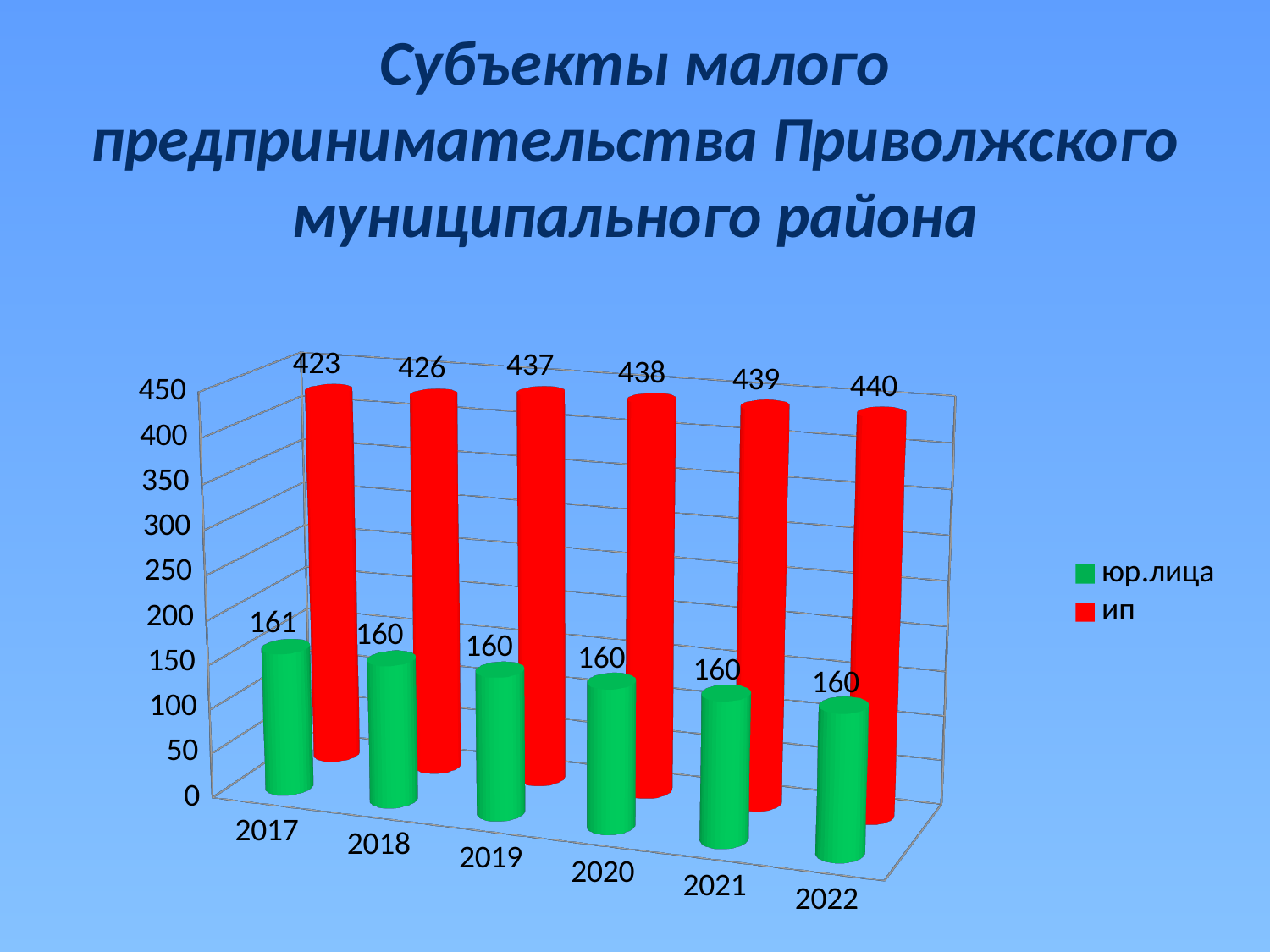
What is the value for ип in 2022? 440 What is the value for ип in 2019? 437 Do the values for ип rise or fall from 2017 to 2022? rise In which year is the value for ип lowest? 2017 What kind of chart is shown on the slide? bar chart In which year is the value for ип highest? 2022 What is the difference between the ип values for 2022 and 2017? 17 What is the value for юр.лица in 2017? 161 How many series does the legend list? 2 How many years are shown on the x axis? 6 Is the value for ип in 2018 greater or less than 400? greater Which is larger in 2020, the value for ип or the value for юр.лица? ип